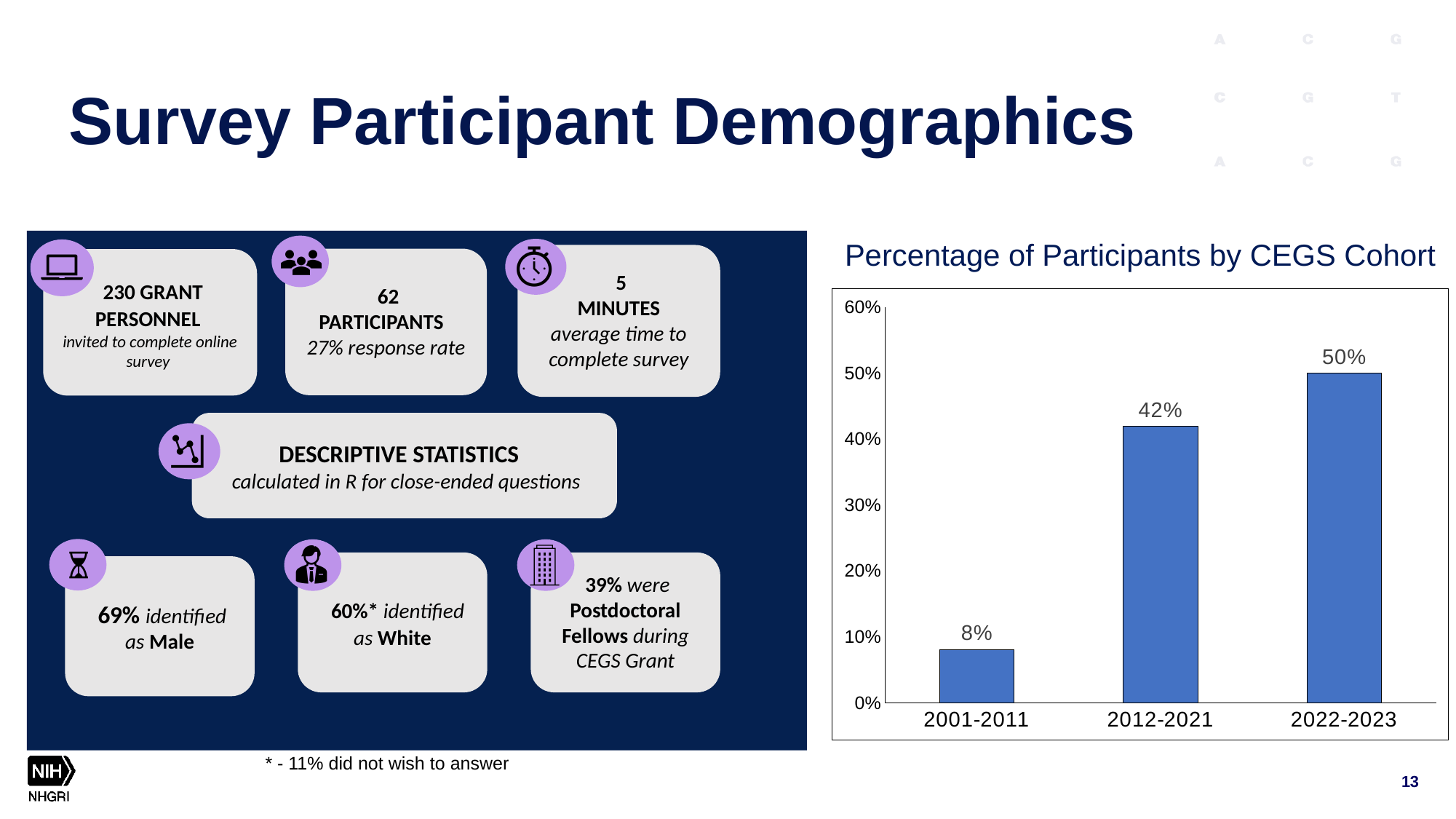
What percentage of participants were in the 2012-2021 CEGS cohort? 42% What is the difference in percentage of participants between the 2022-2023 and 2012-2021 cohorts? 8% Do the values rise or fall from the 2001-2011 cohort to the 2022-2023 cohort? Rise Which CEGS cohort has the highest percentage of participants? 2022-2023 What is the difference in percentage of participants between the 2012-2021 and 2001-2011 cohorts? 34% How many CEGS cohorts are shown on the chart? 3 What percentage of participants were in the 2001-2011 CEGS cohort? 8% What kind of chart is used to show the percentage of participants by CEGS cohort? Bar chart Which CEGS cohort has the lowest percentage of participants? 2001-2011 Is the value for the 2012-2021 cohort greater or less than 40%? greater What percentage of participants were in the 2022-2023 CEGS cohort? 50% Which cohort has a larger percentage of participants, 2001-2011 or 2012-2021? 2012-2021